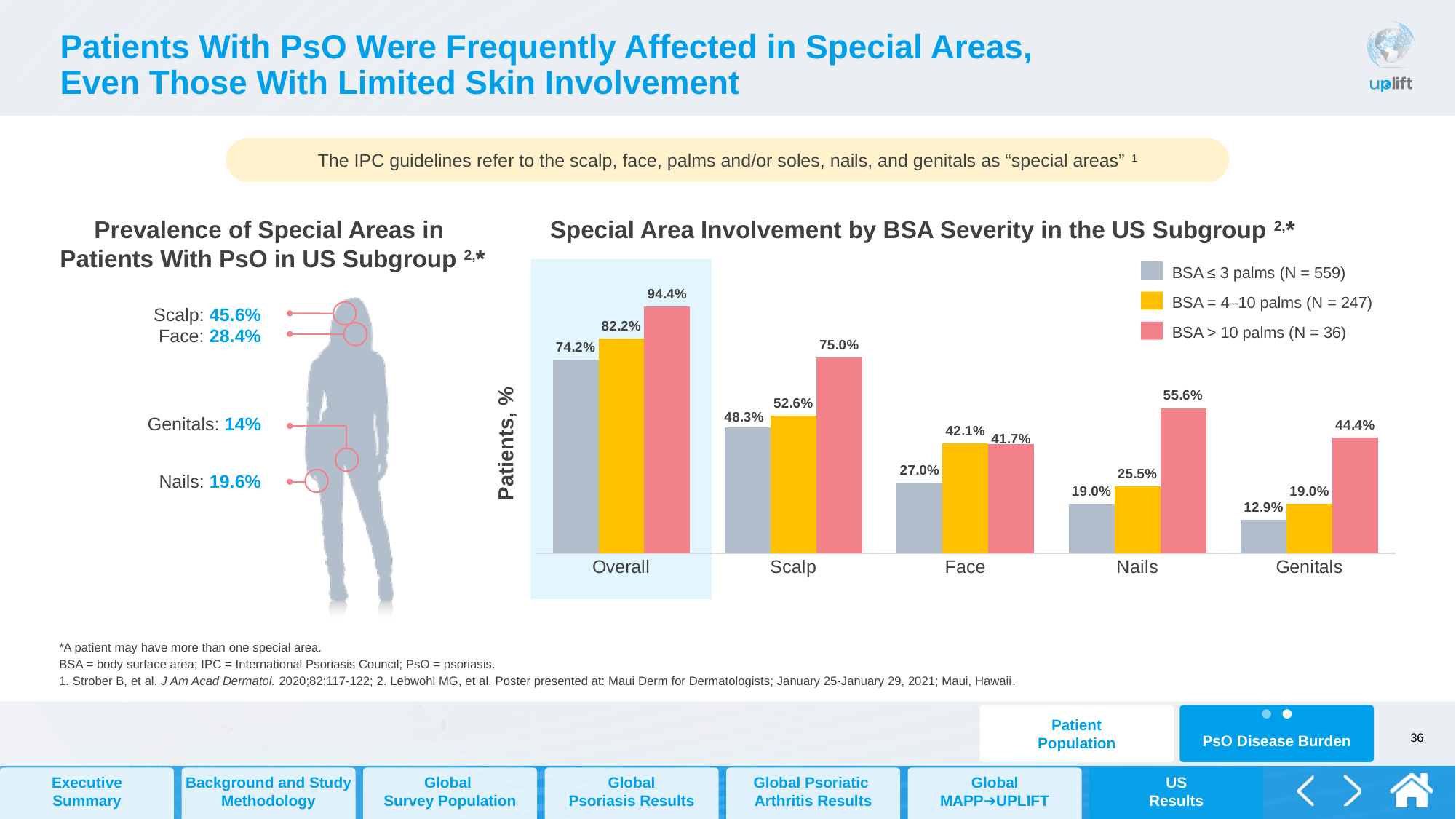
In the bar chart, what is the sample size (N) given in the legend for the BSA > 10 palms series? 36 In the bar chart, which is larger for Face: the BSA = 4–10 palms value or the BSA ≤ 3 palms value? BSA = 4–10 palms How many categories are shown on the x axis of the bar chart? 5 What kind of chart is used to show Special Area Involvement by BSA Severity? Bar chart In the bar chart, what is the value for Scalp in the BSA > 10 palms series? 75.0% In the bar chart, what is the difference between the BSA > 10 palms and BSA ≤ 3 palms values for Nails? 36.6% In the bar chart, what is the value for Genitals in the BSA = 4–10 palms series? 19.0% How many series does the legend of the bar chart list? 3 In the bar chart, which category has the lowest value in the BSA ≤ 3 palms series? Genitals In the bar chart, which category has the highest value in the BSA > 10 palms series? Overall What is the title of the bar chart on the slide? Special Area Involvement by BSA Severity in the US Subgroup In the bar chart, what is the value for Nails in the BSA ≤ 3 palms series? 19.0%